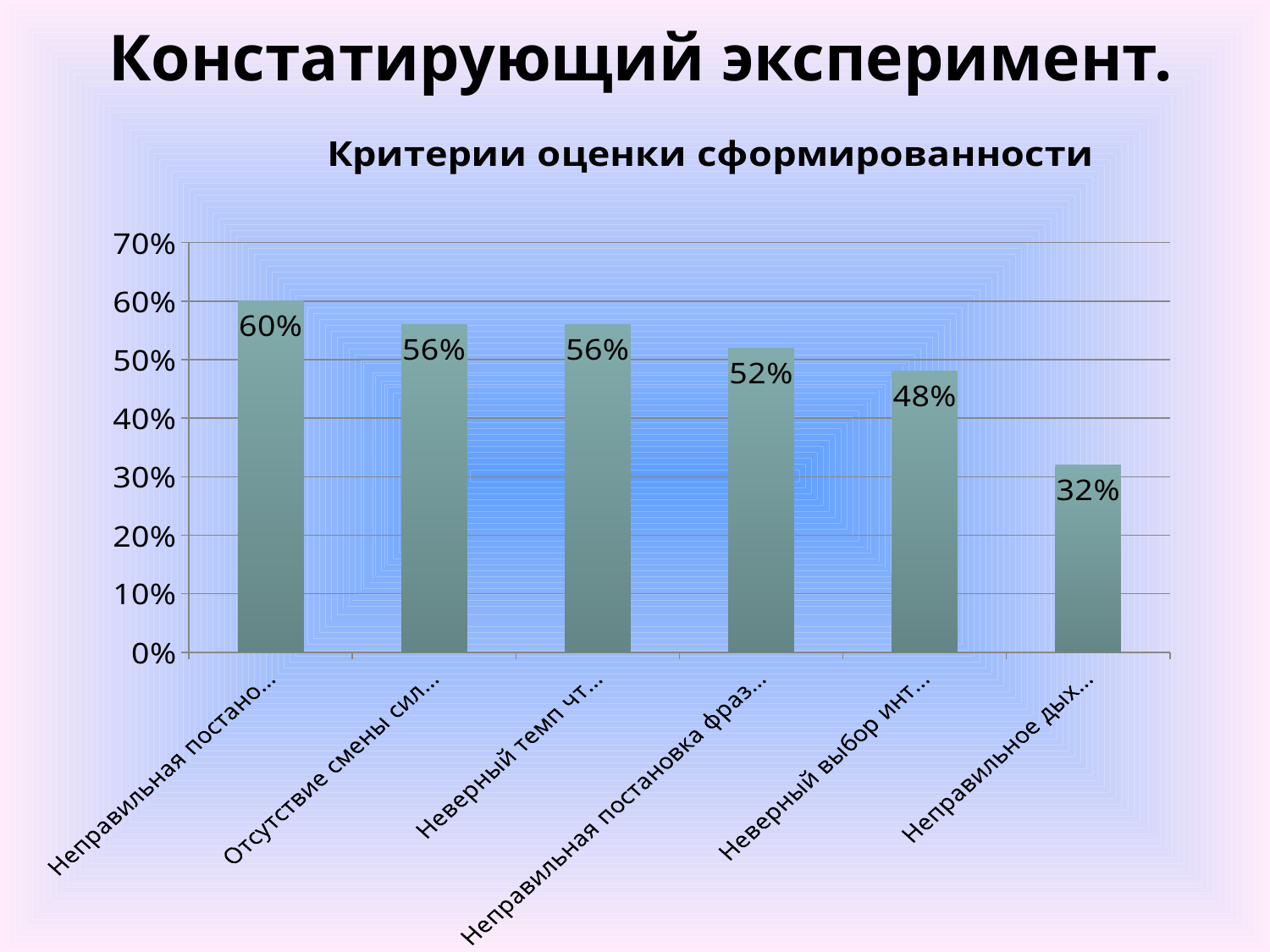
Which category has the highest value in the chart? Неправильная постано... (the first bar), 60% What is the value of the fourth bar from the left (Неправильная постановка фраз...)? 52% Is the value for the last bar (Неправильное дых...) greater or less than 40%? less Which category has the lowest value in the chart? Неправильное дых... (the last bar), 32% Do the bar values rise or fall from left to right across the chart? fall What kind of chart is shown on the slide? bar chart What is the value of the bar labelled 'Неверный выбор инт...'? 48% Which is larger: the value for 'Неправильная постановка фраз...' or the value for 'Неверный выбор инт...'? Неправильная постановка фраз... (52%) What is the value of the bar labelled 'Отсутствие смены сил...'? 56% What is the title of the chart? Критерии оценки сформированности How many bars (categories) does the chart show? 6 What is the difference between the highest bar (60%) and the lowest bar (32%)? 28%